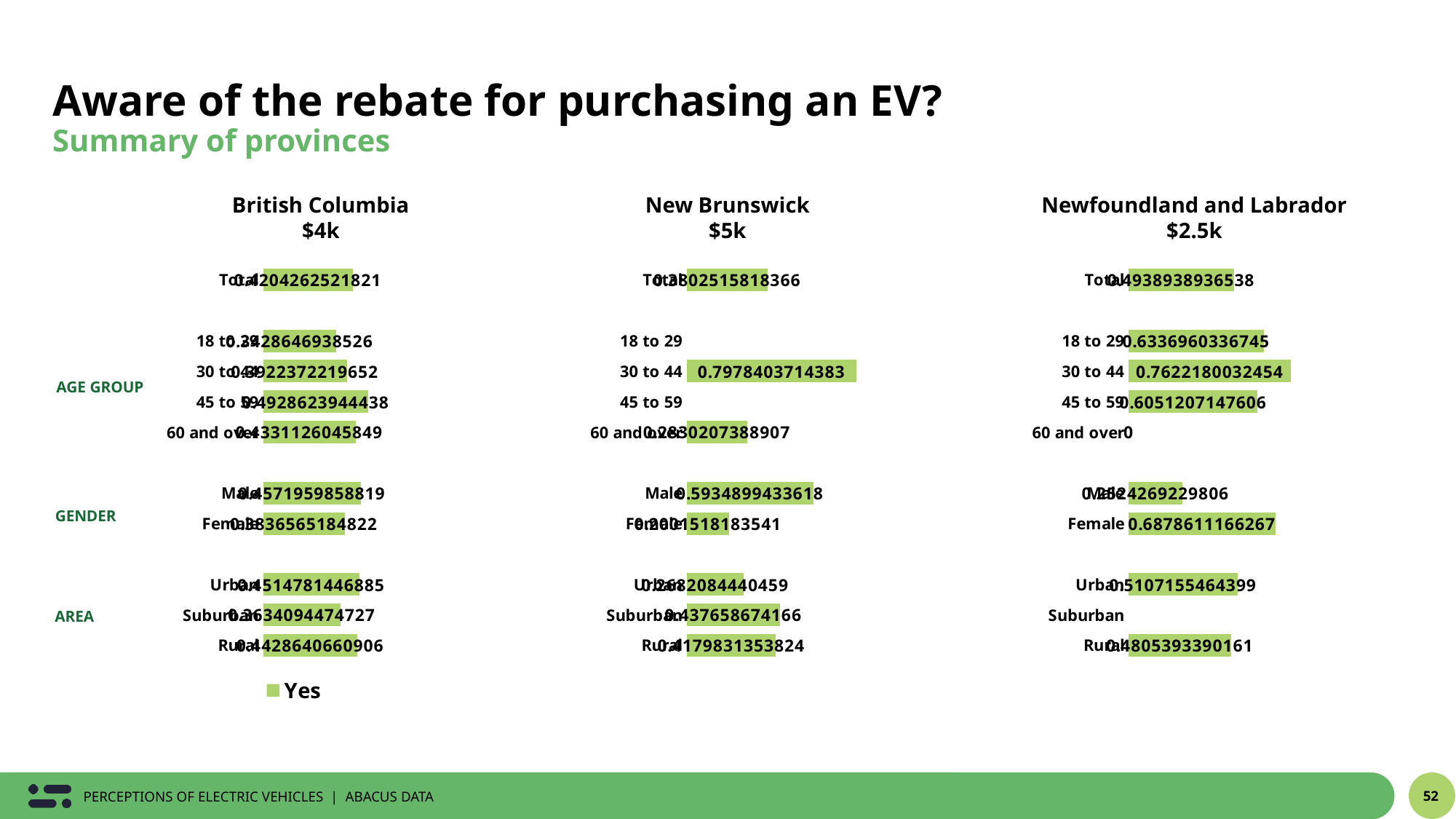
In the New Brunswick $5k chart, what is the value for 30 to 44? 0.7978403714383 In the Newfoundland and Labrador $2.5k chart, what is the value for 60 and over? 0 In the Newfoundland and Labrador $2.5k chart, what is the value for Female? 0.6878611166267 How many series does the legend list? 1 In the Newfoundland and Labrador $2.5k chart, which is larger, Male or Female? Female In the Newfoundland and Labrador $2.5k chart, what is the difference between the 30 to 44 value and the Female value? 0.0743568866187 In the Newfoundland and Labrador $2.5k chart, what is the value for 30 to 44? 0.7622180032454 In the Newfoundland and Labrador $2.5k chart, which category has the lowest value? 60 and over What is the name of the single series shown in the legend? Yes In the New Brunswick $5k chart, what is the value for Male? 0.5934899433618 In the New Brunswick $5k chart, which category has the highest value? 30 to 44 What kind of chart is used for the British Columbia $4k panel? bar chart